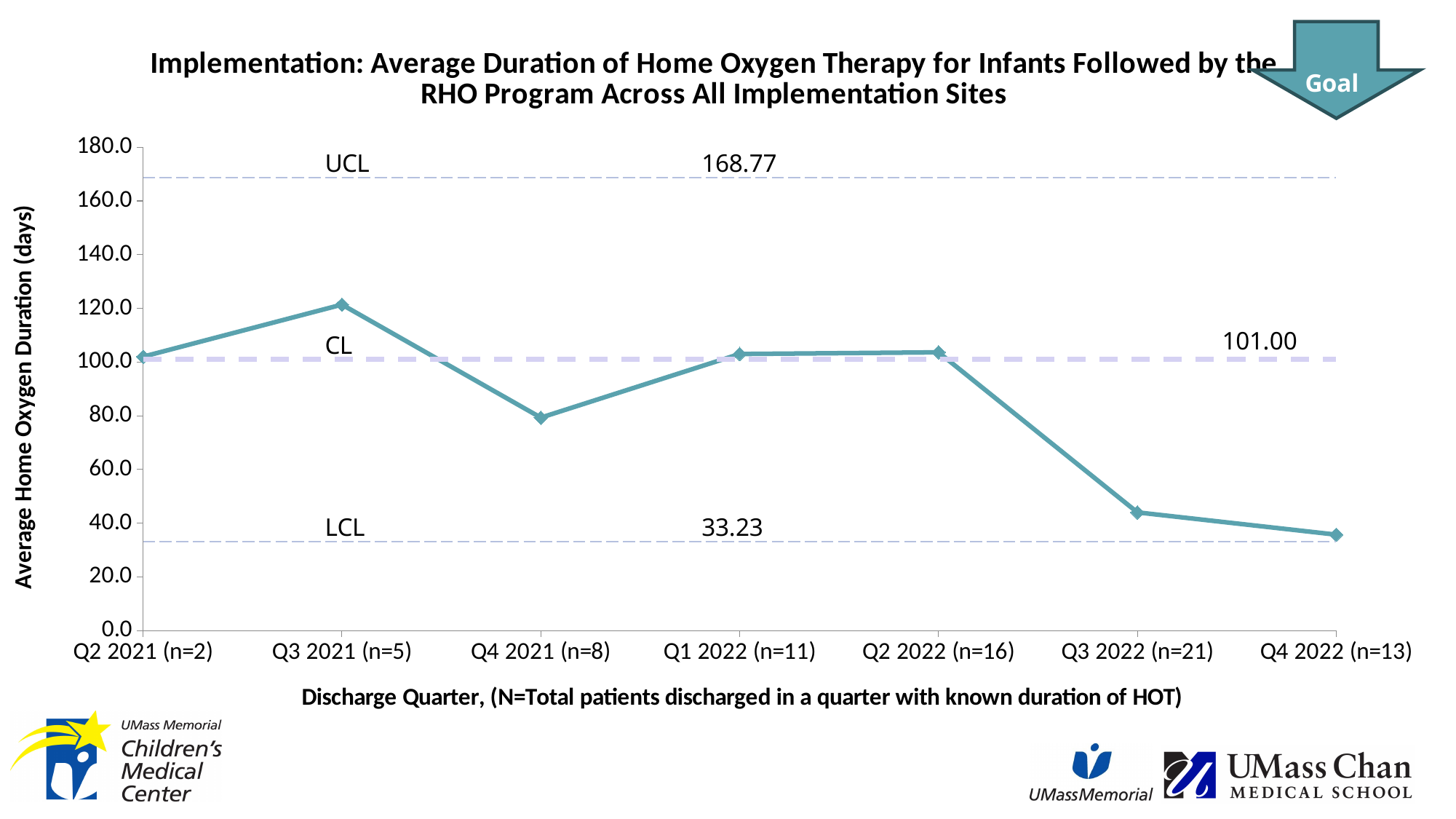
What is the value of the center line (CL)? 101.00 Which has a higher average home oxygen duration, Q3 2021 (n=5) or Q4 2021 (n=8)? Q3 2021 (n=5) Is the average home oxygen duration for Q3 2021 (n=5) greater or less than 100.0 days? greater What is the value of the upper control limit (UCL)? 168.77 Do the values rise or fall from Q2 2022 (n=16) to Q4 2022 (n=13)? fall How many discharge quarters are plotted on the x axis? 7 Is the average home oxygen duration for Q3 2022 (n=21) greater or less than 60.0 days? less Which discharge quarter has the highest average home oxygen duration? Q3 2021 (n=5) Which discharge quarter has the lowest average home oxygen duration? Q4 2022 (n=13) What kind of chart is shown on the slide? line chart What is the value of the lower control limit (LCL)? 33.23 What is the difference between the UCL and the LCL? 135.54